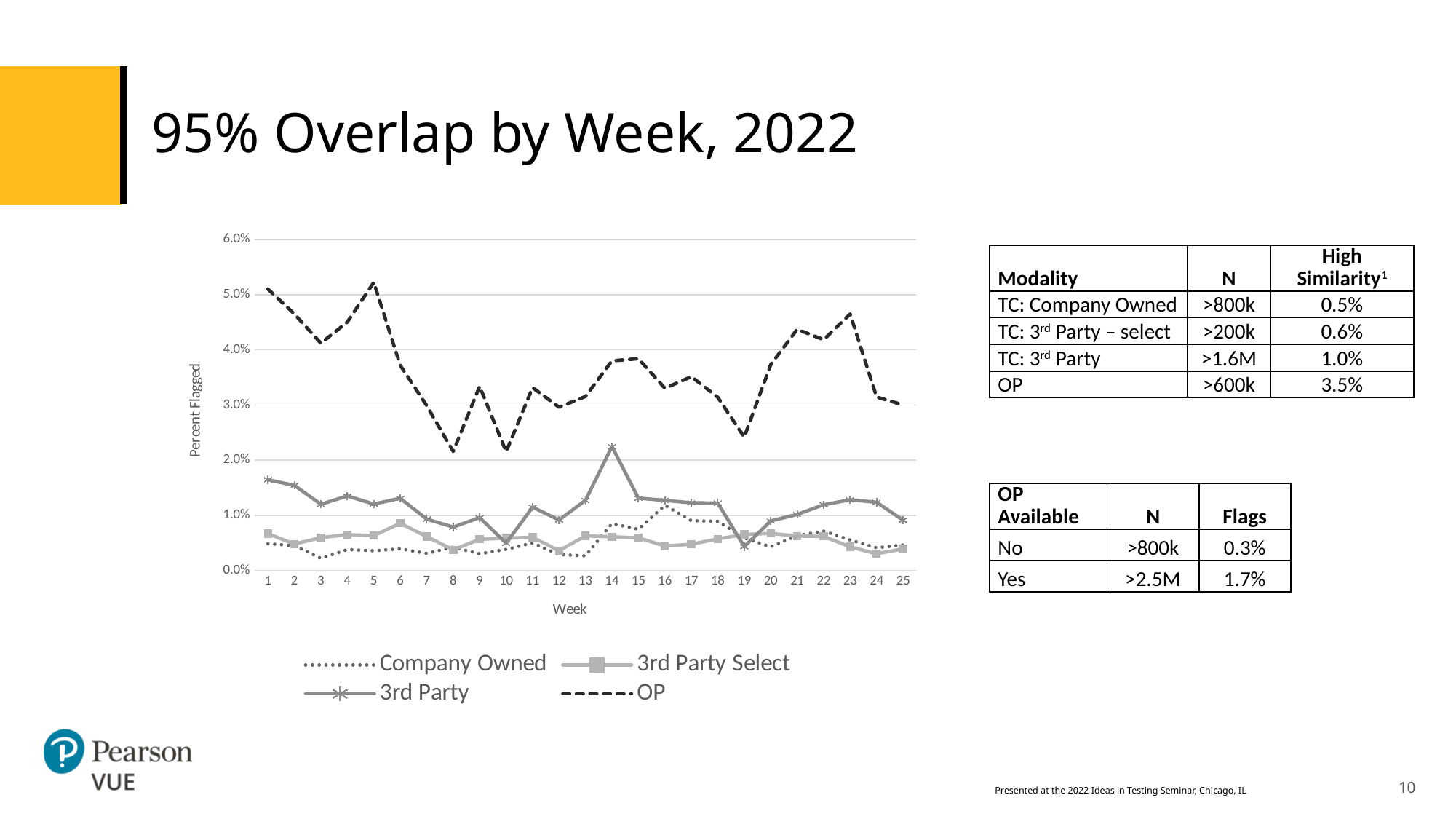
What kind of chart is shown on the slide? line chart At week 13, which series has the lowest value? Company Owned What is the title of the chart's vertical axis? Percent Flagged At week 1, which series has the larger value: OP or Company Owned? OP For the 3rd Party series, which week has the larger value: week 14 or week 15? week 14 How many weeks are plotted along the x axis of the chart? 25 Does the OP series rise or fall from week 5 to week 8? fall Is the value for OP at week 23 greater or less than 4.0%? greater Which series has the highest values across the chart? OP How many series does the chart legend list? 4 Is the value for 3rd Party at week 14 greater or less than 1.0%? greater Is the value for OP at week 8 greater or less than 3.0%? less